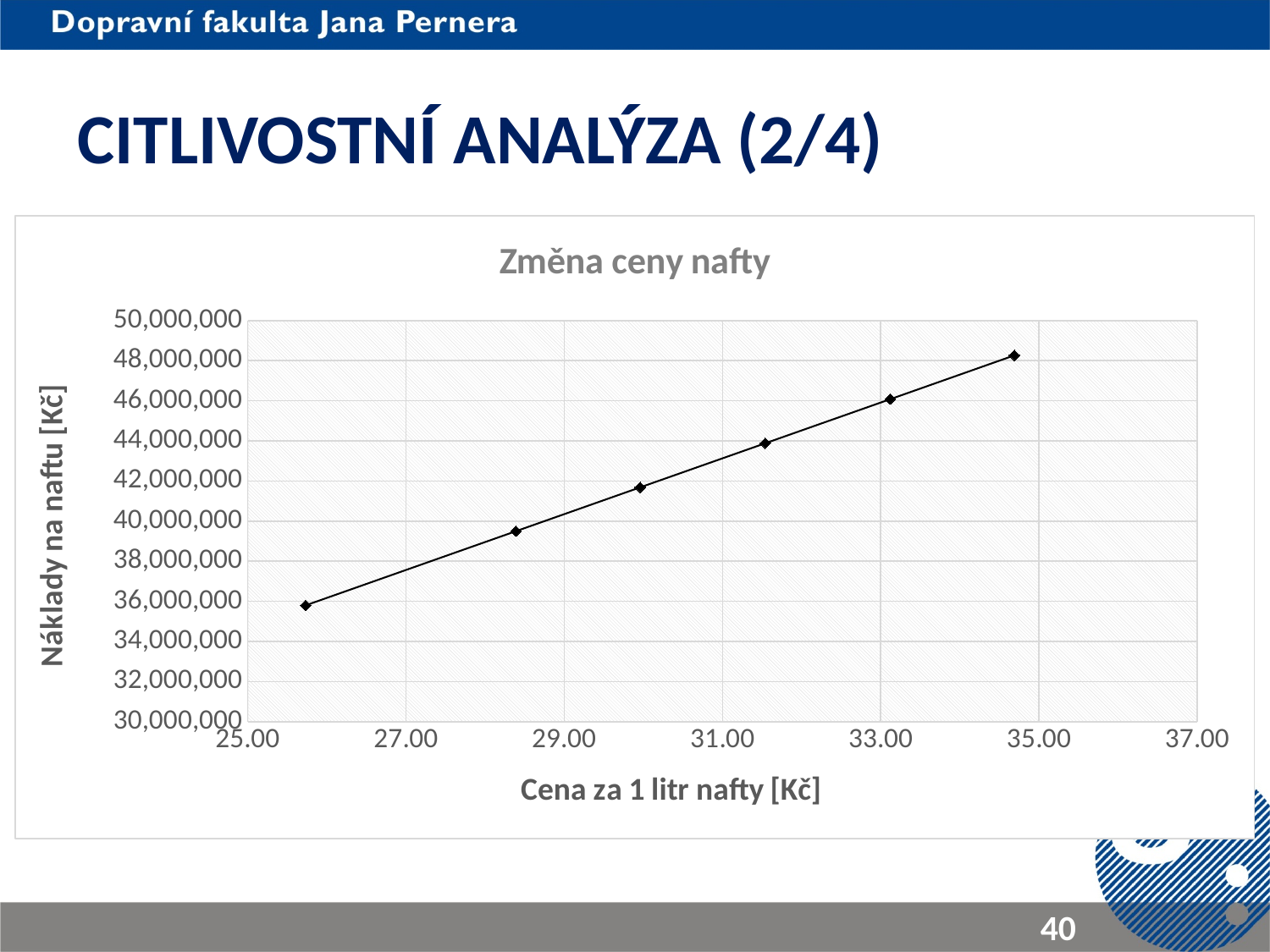
Is the value for the rightmost data point greater or less than 50,000,000? less How many data points are plotted on the chart? 6 Is the value for the leftmost data point greater or less than 38,000,000? less Do the plotted values rise or fall as the price per litre increases along the x axis? rise Is the value for the rightmost data point greater or less than 46,000,000? greater What is the title of the chart? Změna ceny nafty What is the label of the x axis? Cena za 1 litr nafty [Kč] What kind of chart is shown on the slide? line chart Which data point has the highest cost: the one at the lowest price per litre or the one at the highest price per litre? the one at the highest price per litre